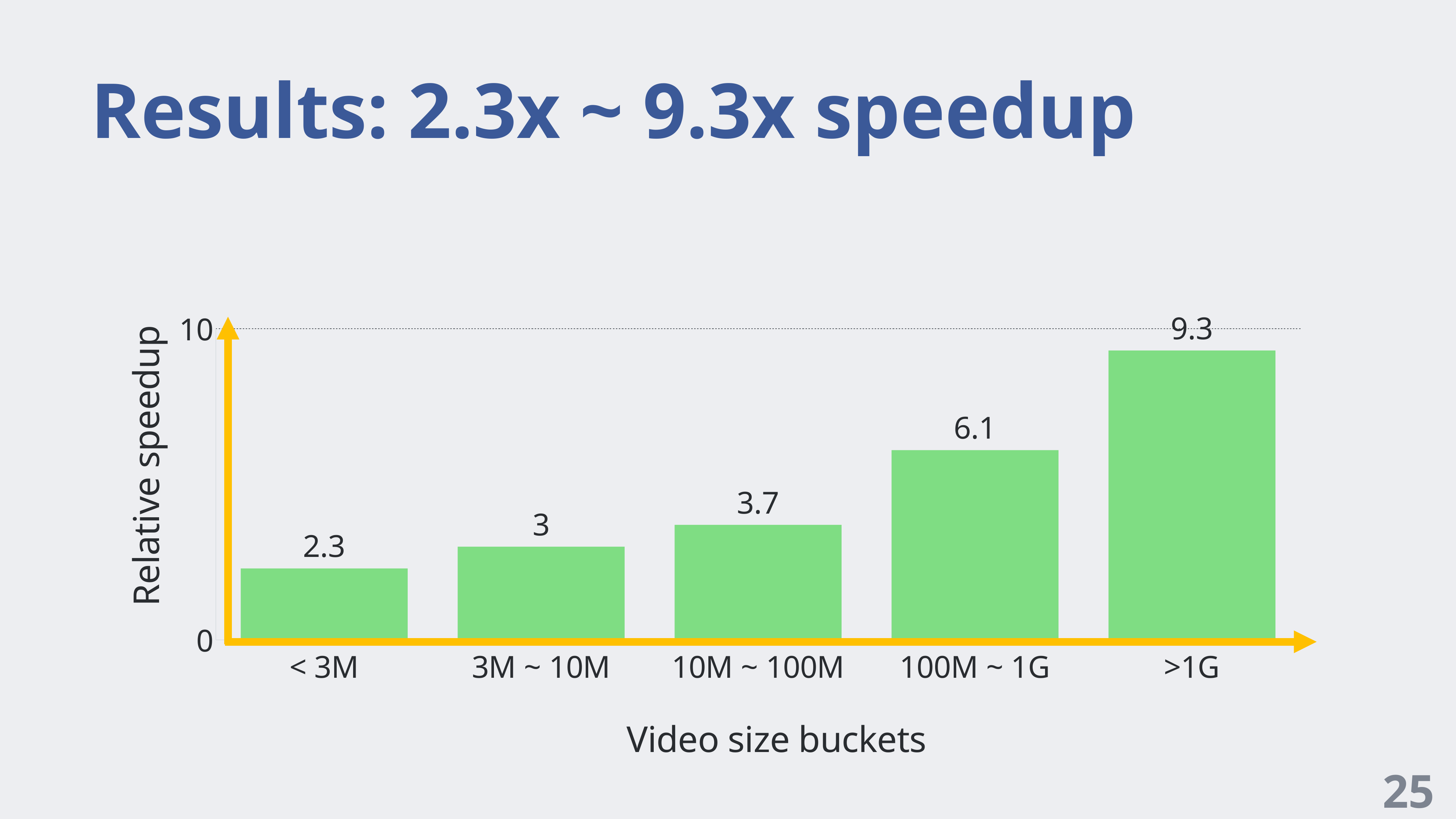
What is the relative speedup for the 100M ~ 1G bucket? 6.1 What is the relative speedup for the 10M ~ 100M bucket? 3.7 What is the relative speedup for the 3M ~ 10M bucket? 3 Which video size bucket has the highest relative speedup? >1G What kind of chart is shown on the slide? Bar chart What is the difference in relative speedup between the 100M ~ 1G bucket and the 10M ~ 100M bucket? 2.4 How many video size buckets are shown in the chart? 5 Do the relative speedup values rise or fall as the video size buckets increase along the x axis? Rise What is the relative speedup for the < 3M video size bucket? 2.3 What is the difference in relative speedup between the >1G bucket and the < 3M bucket? 7 Which has a larger relative speedup, the 3M ~ 10M bucket or the 100M ~ 1G bucket? 100M ~ 1G Which video size bucket has the lowest relative speedup? < 3M